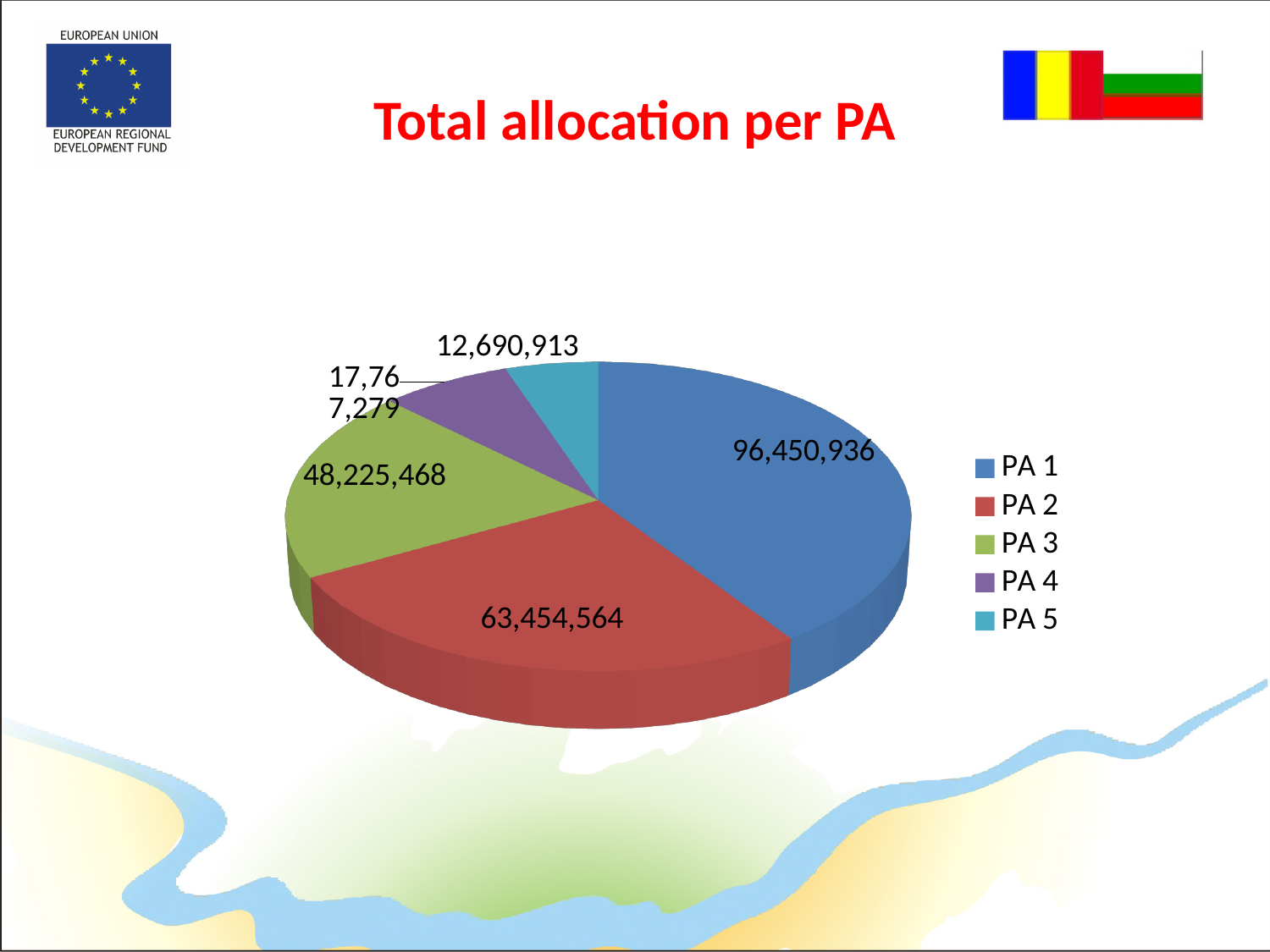
Which colour represents PA 3 in the chart? Green Which has a larger allocation, PA 2 or PA 3? PA 2 What is the allocation for PA 1? 96,450,936 What is the allocation for PA 5? 12,690,913 What is the allocation for PA 2? 63,454,564 Which PA has the largest allocation? PA 1 Which PA has the smallest allocation? PA 5 What is the allocation for PA 3? 48,225,468 What is the difference between the allocations for PA 1 and PA 2? 32,996,372 How many categories does the legend list? 5 What type of chart is shown on the slide? Pie chart What is the title of the chart? Total allocation per PA